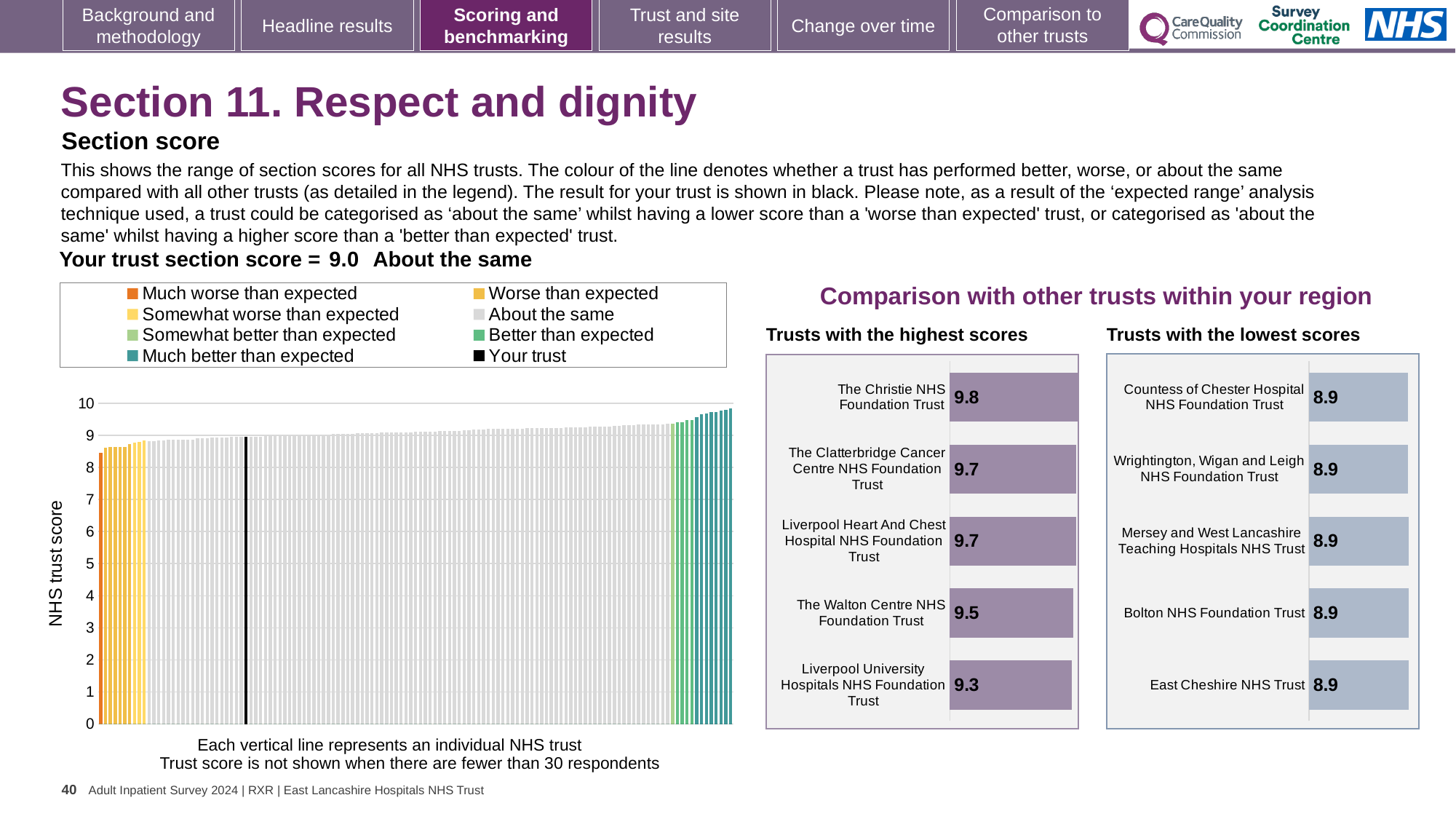
In the main 'NHS trust score' chart, do the trust scores rise or fall from left to right? Rise In the 'Trusts with the highest scores' chart, what is the score for The Christie NHS Foundation Trust? 9.8 In the 'Trusts with the highest scores' chart, which has the larger score: The Clatterbridge Cancer Centre NHS Foundation Trust or The Walton Centre NHS Foundation Trust? The Clatterbridge Cancer Centre NHS Foundation Trust In the 'Trusts with the highest scores' chart, which trust has the highest score? The Christie NHS Foundation Trust In the 'Trusts with the highest scores' chart, which trust has the lowest score? Liverpool University Hospitals NHS Foundation Trust In the 'Trusts with the highest scores' chart, what is the difference between the scores of The Christie NHS Foundation Trust and Liverpool University Hospitals NHS Foundation Trust? 0.5 How many trusts are listed in the 'Trusts with the lowest scores' chart? 5 What kind of chart is the main 'NHS trust score' chart? Bar chart In the main 'NHS trust score' chart, what is the section score for your trust? 9.0 In the 'Trusts with the highest scores' chart, what is the score for The Walton Centre NHS Foundation Trust? 9.5 How many entries does the legend of the main 'NHS trust score' chart list? 8 In the 'Trusts with the lowest scores' chart, what is the score for Bolton NHS Foundation Trust? 8.9